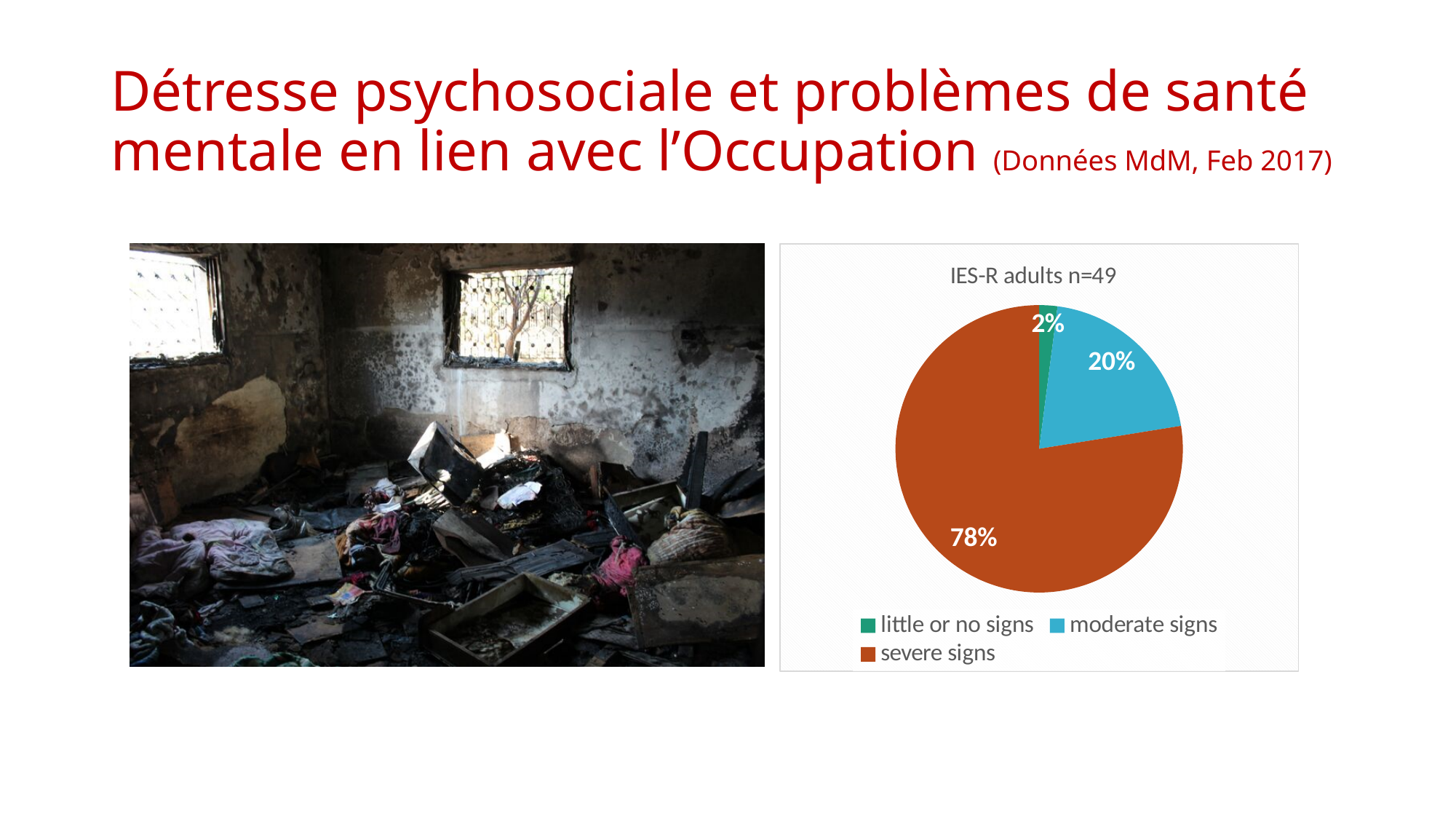
What type of chart is shown on the slide? pie chart What percentage of the pie is labelled 'moderate signs'? 20% Which category has the largest share of the pie? severe signs Which category has the smallest share of the pie? little or no signs What percentage of the pie is labelled 'little or no signs'? 2% What colour is the 'moderate signs' slice? blue Which is larger: the share for 'moderate signs' or the share for 'little or no signs'? moderate signs What is the difference in percentage points between 'severe signs' and 'moderate signs'? 58 How many entries does the legend list? 3 What percentage of the pie is labelled 'severe signs'? 78% How many categories does the pie chart have? 3 What is the title of the chart? IES-R adults n=49